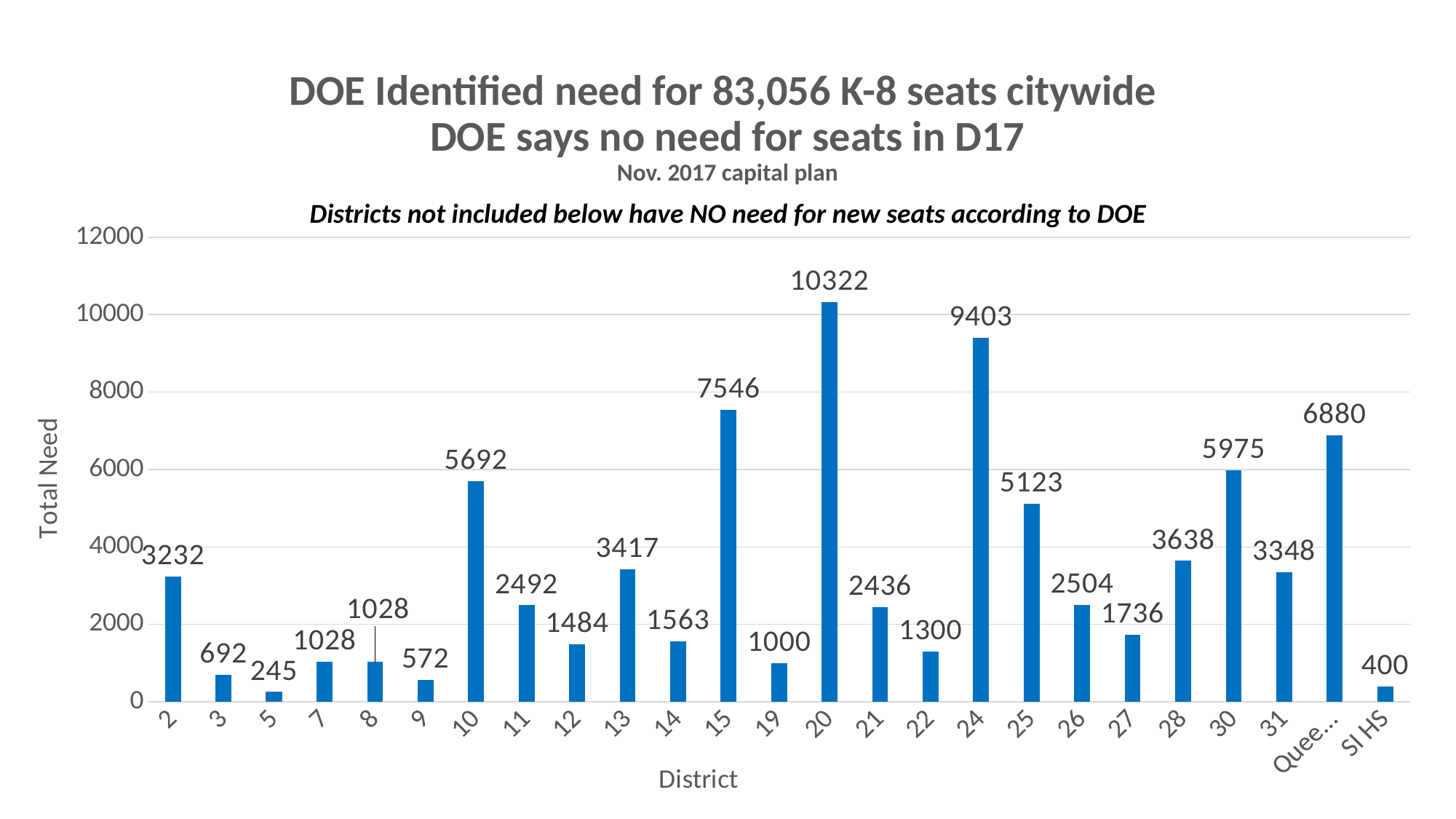
Which district has the lowest total need? 5 What is the total need for District 28? 3638 What is the total need for District 15? 7546 What is the total need for District 20? 10322 What is the label of the y axis? Total Need What is the total need for SI HS? 400 What is the difference in total need between District 15 and District 10? 1854 Which has a larger total need, District 30 or District 25? District 30 How many districts are shown on the x axis? 25 What is the difference in total need between District 20 and District 24? 919 Which district has the highest total need? 20 What kind of chart is shown on the slide? Bar chart